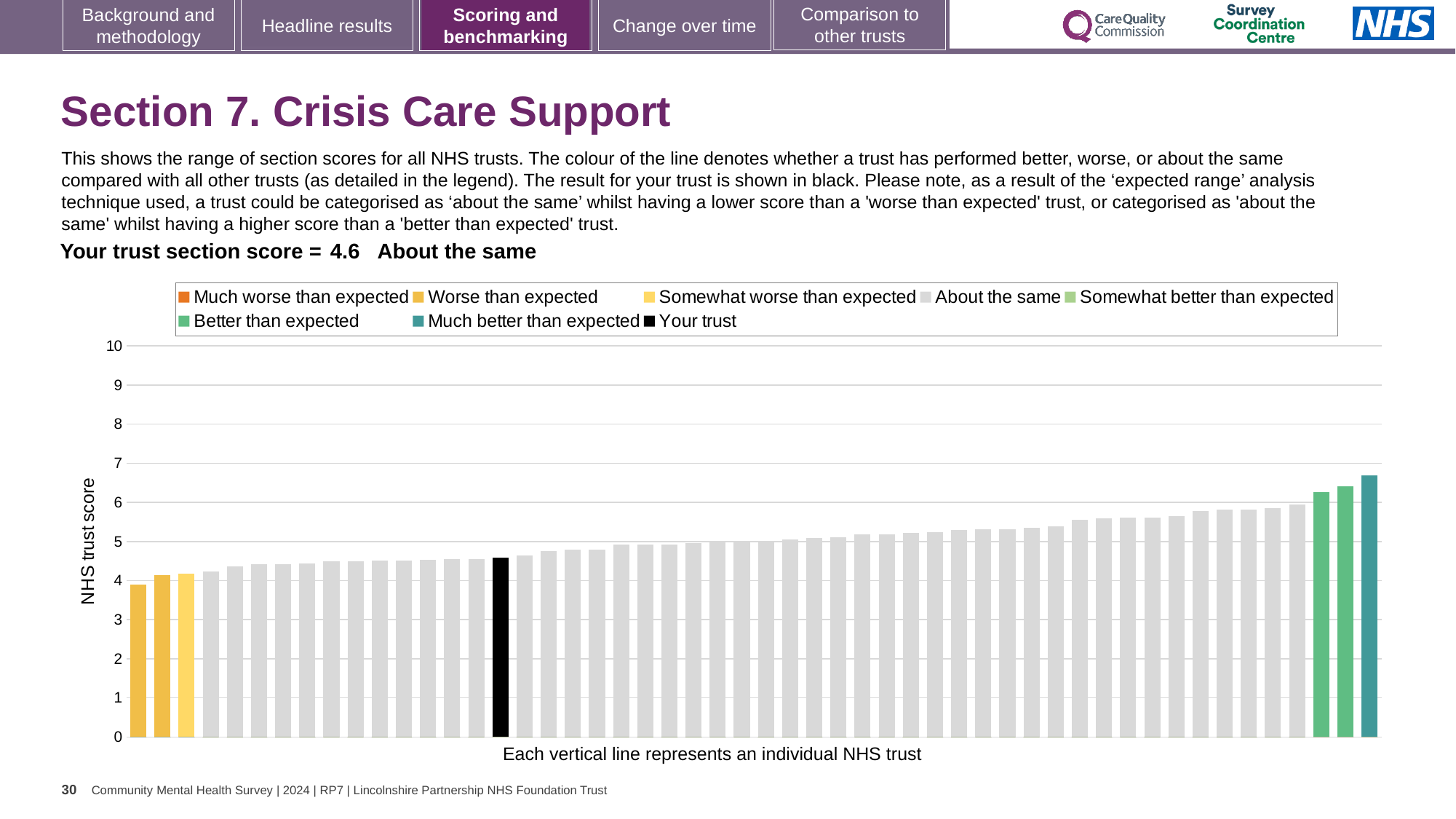
Which legend category does the tallest bar belong to? Much better than expected Is the value of the tallest bar greater or less than 7? less Do the bar values rise or fall from left to right along the x axis? Rise How many entries does the chart legend list? 8 What is the label on the vertical axis of the chart? NHS trust score What is the section score for your trust shown on the slide? 4.6 Is the value of the tallest bar greater or less than 6? greater What kind of chart is shown on the slide? Bar chart Is the bar for your trust higher or lower than the rightmost bar? Lower How many bars are coloured as 'Much better than expected'? 1 Is the value for your trust greater or less than 4? greater